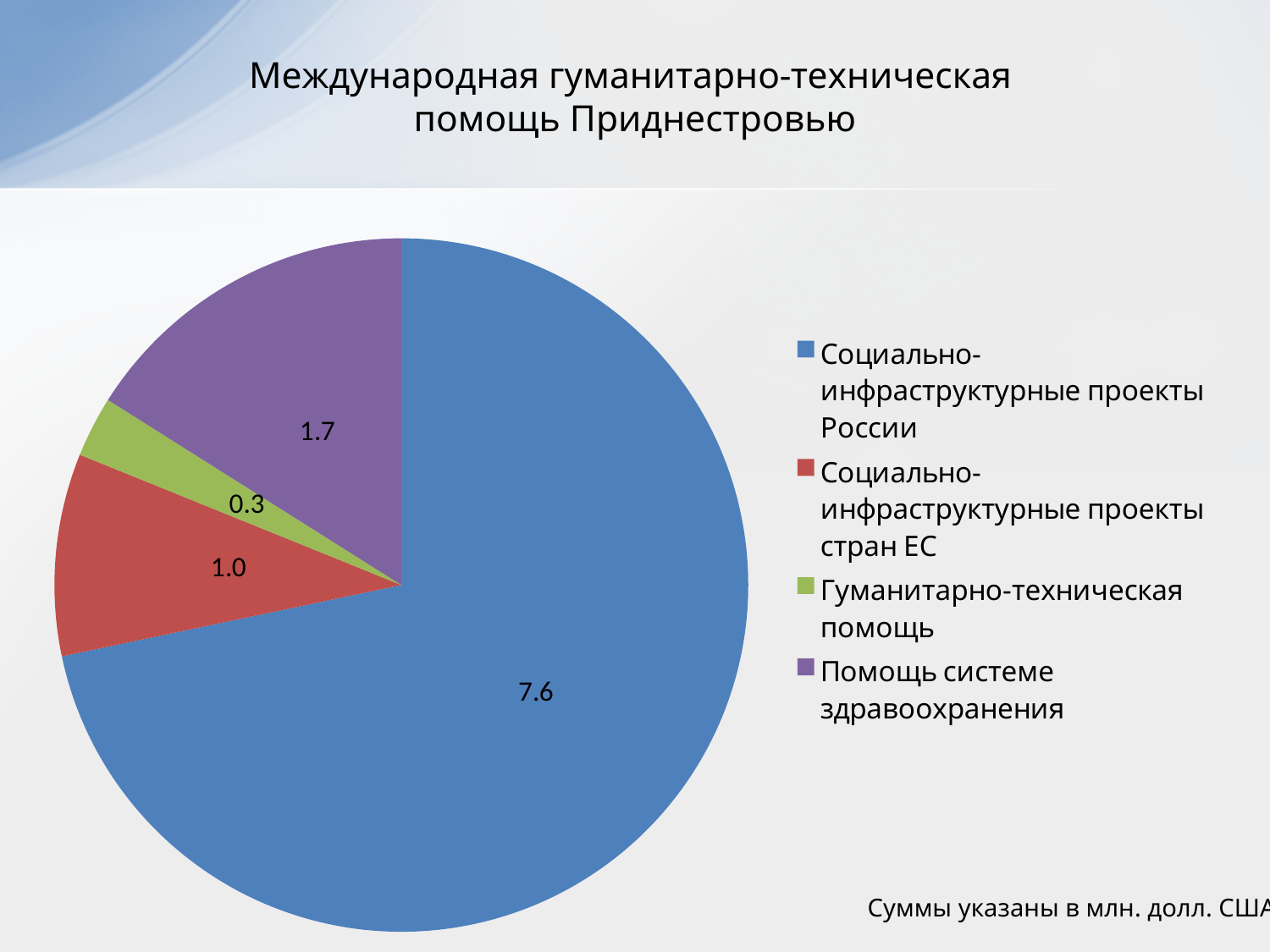
What is the value for Гуманитарно-техническая помощь? 0.3 Which category has the smallest slice of the pie? Гуманитарно-техническая помощь Which is larger: Помощь системе здравоохранения or Социально-инфраструктурные проекты стран ЕС? Помощь системе здравоохранения What is the value for Помощь системе здравоохранения? 1.7 What type of chart is shown on the slide? pie chart How many slices does the pie chart have? 4 What is the difference between the values for Социально-инфраструктурные проекты России and Помощь системе здравоохранения? 5.9 In what units are the amounts on the chart given, according to the note on the slide? млн. долл. США Which category has the largest slice of the pie? Социально-инфраструктурные проекты России What is the value for Социально-инфраструктурные проекты стран ЕС? 1.0 What is the value for Социально-инфраструктурные проекты России? 7.6 What share of the pie does Социально-инфраструктурные проекты России represent? 71.7%